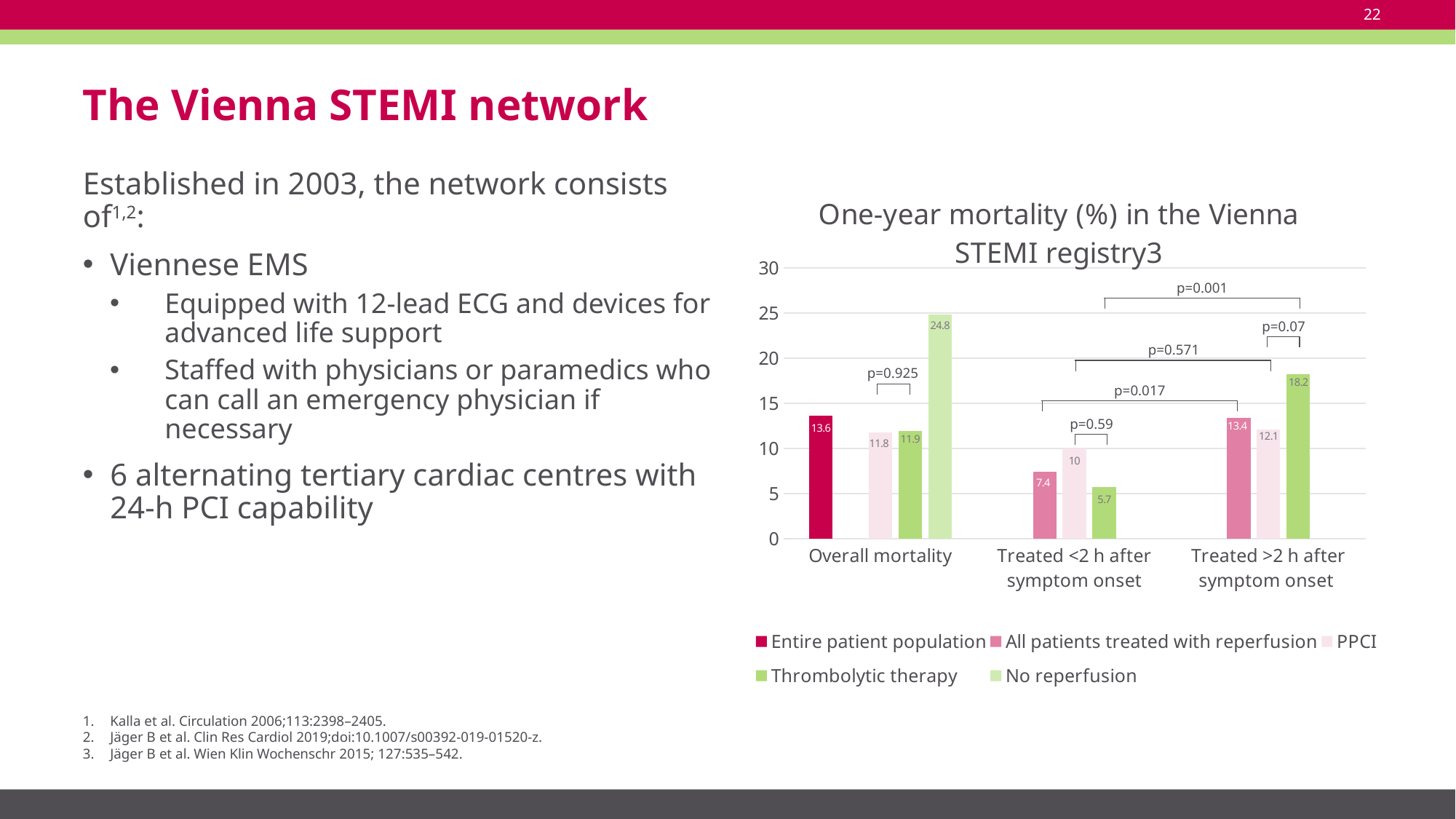
Is the No reperfusion value under Overall mortality greater or less than 20? greater What is the value for PPCI in the Treated >2 h after symptom onset category? 12.1 What is the one-year mortality for the No reperfusion group under Overall mortality? 24.8 How many categories are shown on the x axis? 3 What is the value for Thrombolytic therapy in the Treated <2 h after symptom onset category? 5.7 Which bar in the Treated <2 h after symptom onset category has the lowest value? Thrombolytic therapy How many series does the legend list? 5 Which is larger: the PPCI value for Treated <2 h after symptom onset or for Treated >2 h after symptom onset? Treated >2 h after symptom onset What is the value for the Entire patient population bar under Overall mortality? 13.6 What is the difference between the Thrombolytic therapy values for Treated >2 h and Treated <2 h after symptom onset? 12.5 Which bar in the Overall mortality category has the highest value? No reperfusion What type of chart is shown on the slide? Bar chart